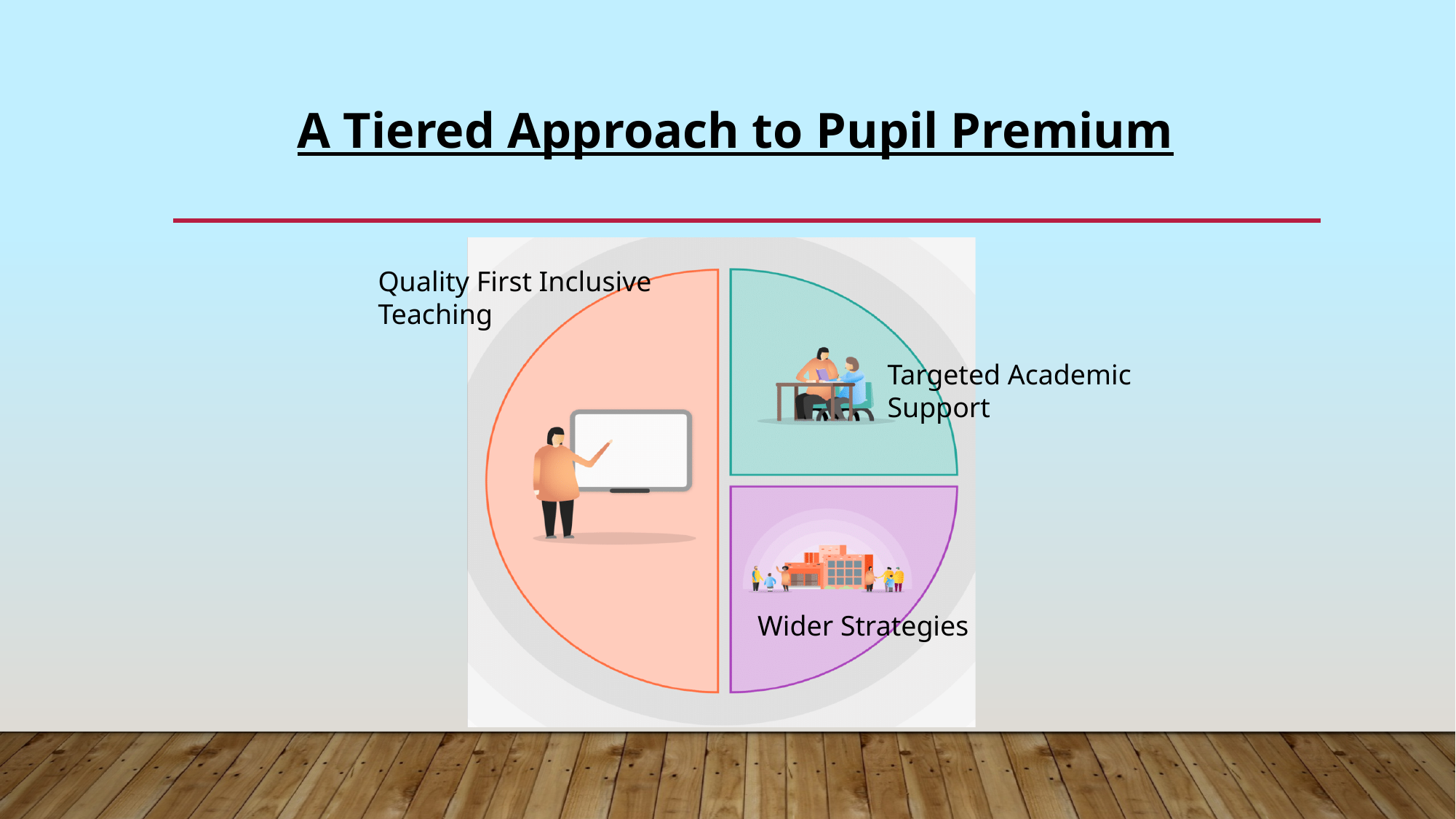
Which segment of the pie chart is the largest? Quality First Inclusive Teaching What colour is the Wider Strategies segment of the pie chart? purple What is the title of the slide containing the pie chart? A Tiered Approach to Pupil Premium What kind of chart is shown on the slide? pie chart Which is larger in the pie chart: Quality First Inclusive Teaching or Targeted Academic Support? Quality First Inclusive Teaching Which is larger in the pie chart: Wider Strategies or Quality First Inclusive Teaching? Quality First Inclusive Teaching How many segments does the pie chart have? 3